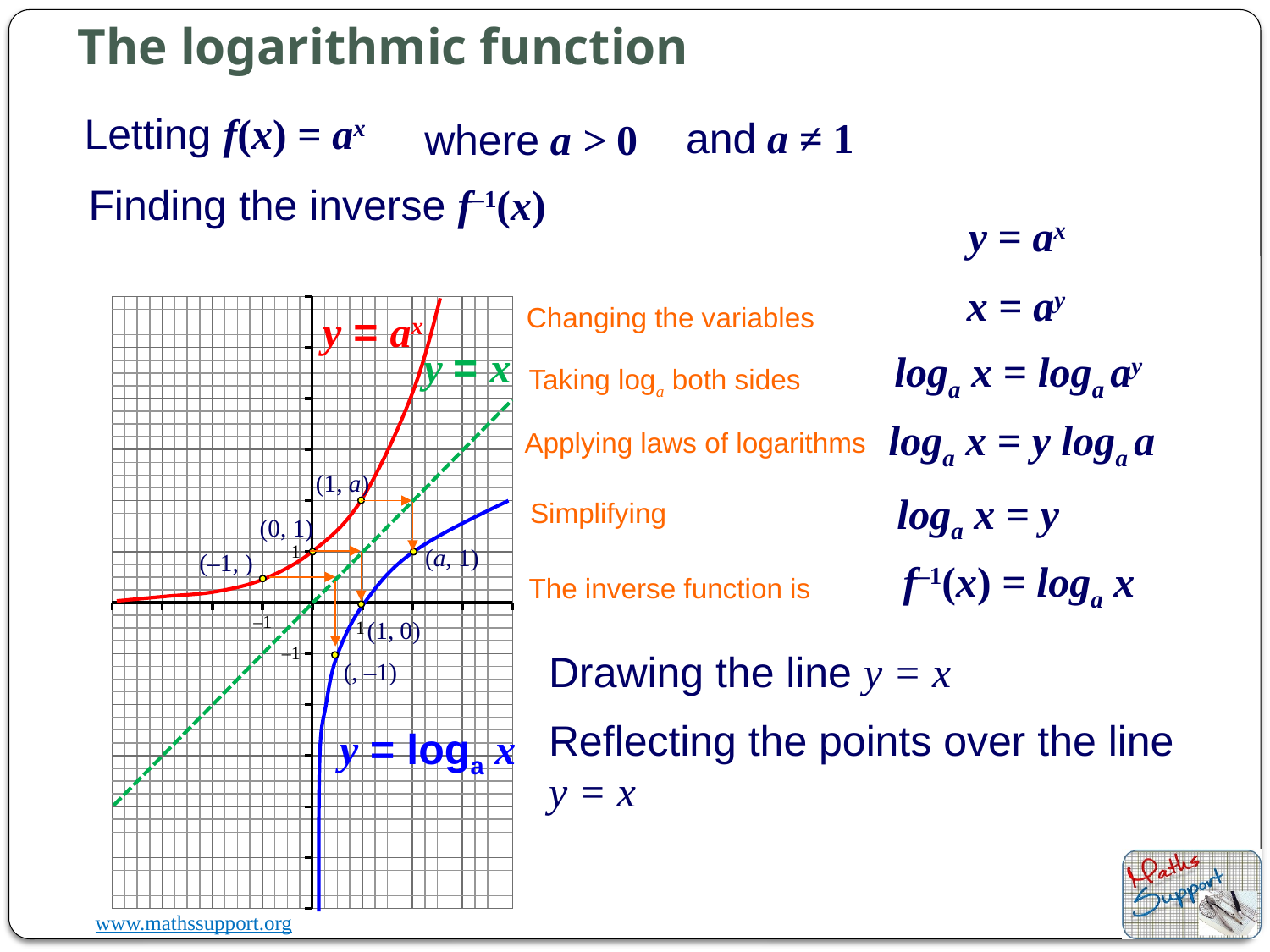
What is the equation written on the red curve in the graph? y = a^x How many curves or lines are plotted on the graph? 3 What kind of chart is shown on the slide? line graph Does the red curve y = a^x rise or fall as x increases? rise What is the equation written on the blue curve in the graph? y = log_a x Which labelled point on the blue curve lies on the x-axis? (1, 0) Does the blue curve y = log_a x rise or fall as x increases? rise Which labelled point on the red curve lies on the y-axis? (0, 1) The point (1, a) on the red curve is reflected over the line y = x to which labelled point on the blue curve? (a, 1) What colour is the line y = x drawn in? green Which curve passes through the point (0, 1)? y = a^x What is the equation of the green dashed line in the graph? y = x